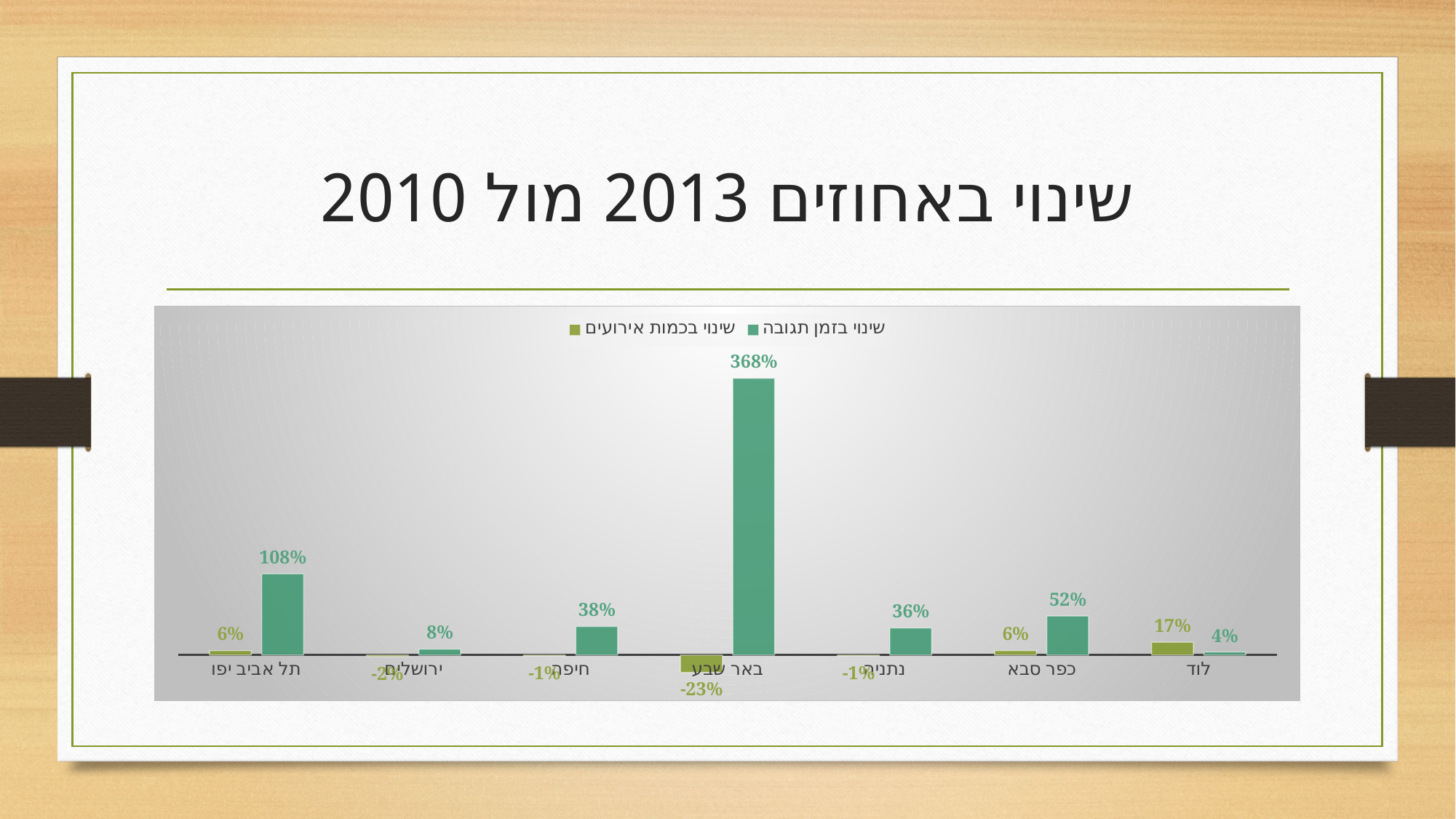
Which city has the lowest value in the 'שינוי בזמן תגובה' (change in response time) series? לוד (Lod) How many series does the legend list? 2 What is the difference between the 'שינוי בזמן תגובה' values for כפר סבא (Kfar Saba) and חיפה (Haifa)? 14% What is the value of the 'שינוי בזמן תגובה' (change in response time) series for באר שבע (Beer Sheva)? 368% How many cities (categories) are shown on the x axis? 7 What is the value of the 'שינוי בזמן תגובה' (change in response time) series for תל אביב יפו (Tel Aviv-Yafo)? 108% What is the title of the slide? שינוי באחוזים 2013 מול 2010 What is the value of the 'שינוי בכמות אירועים' (change in number of events) series for לוד (Lod)? 17% What type of chart is shown on the slide? Bar chart Which city has the highest value in the 'שינוי בזמן תגובה' (change in response time) series? באר שבע (Beer Sheva) What is the value of the 'שינוי בכמות אירועים' (change in number of events) series for באר שבע (Beer Sheva)? -23% Which is larger: the 'שינוי בזמן תגובה' value for נתניה (Netanya) or for ירושלים (Jerusalem)? נתניה (Netanya)